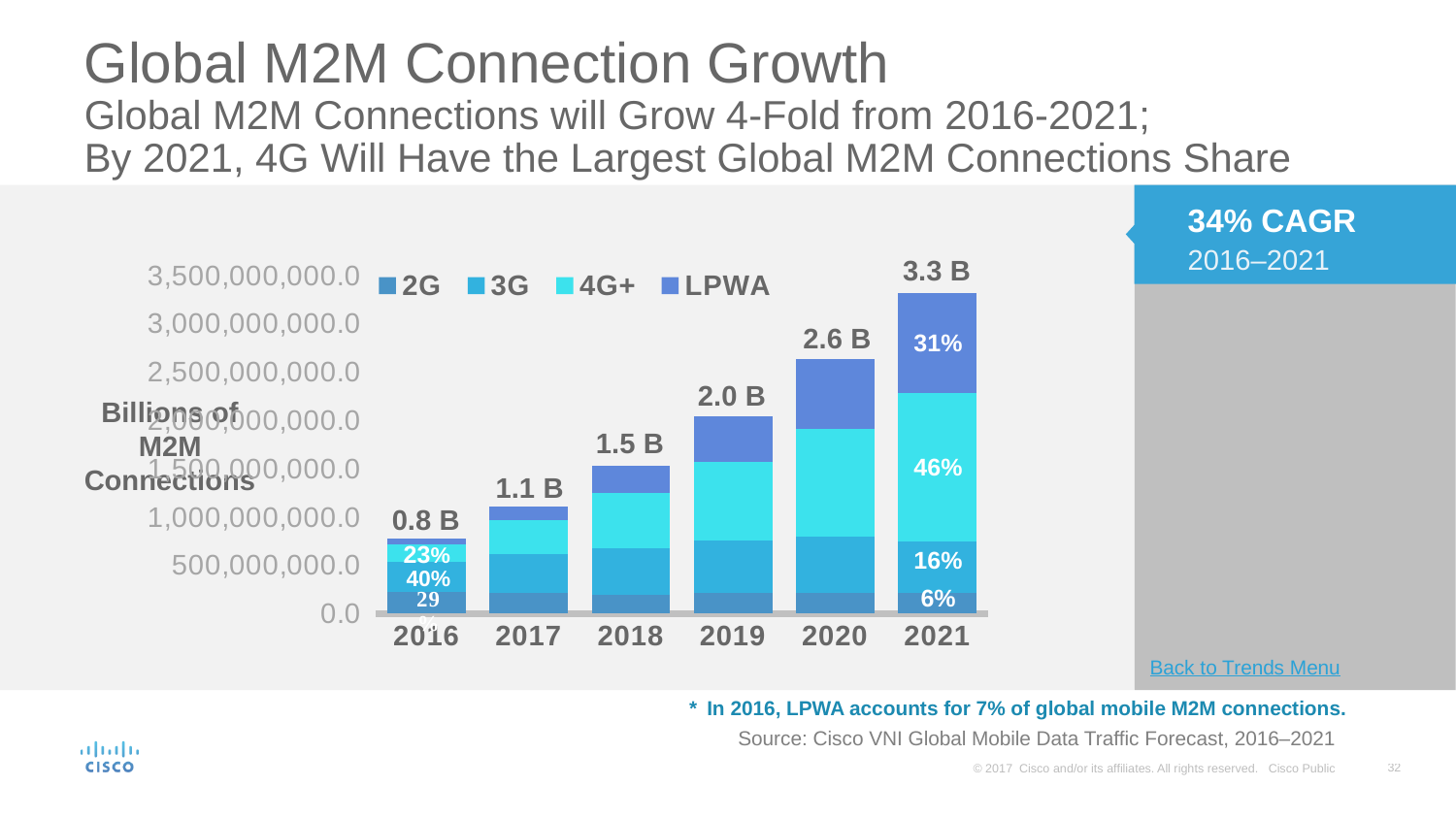
What is the total number of global M2M connections shown for 2016? 0.8 B What is the total number of global M2M connections shown for 2021? 3.3 B Do total M2M connections rise or fall from 2016 to 2021? Rise What is the total number of global M2M connections shown for 2019? 2.0 B What kind of chart is shown on the slide? Stacked bar chart What share of global M2M connections does 3G account for in 2016? 40% Which year has the highest total M2M connections? 2021 What share of global M2M connections does 4G+ account for in 2021? 46% How many series does the legend list? 4 How many years are shown on the x axis? 6 Which year has the lowest total M2M connections? 2016 What is the difference between the total M2M connections in 2021 and 2016? 2.5 B